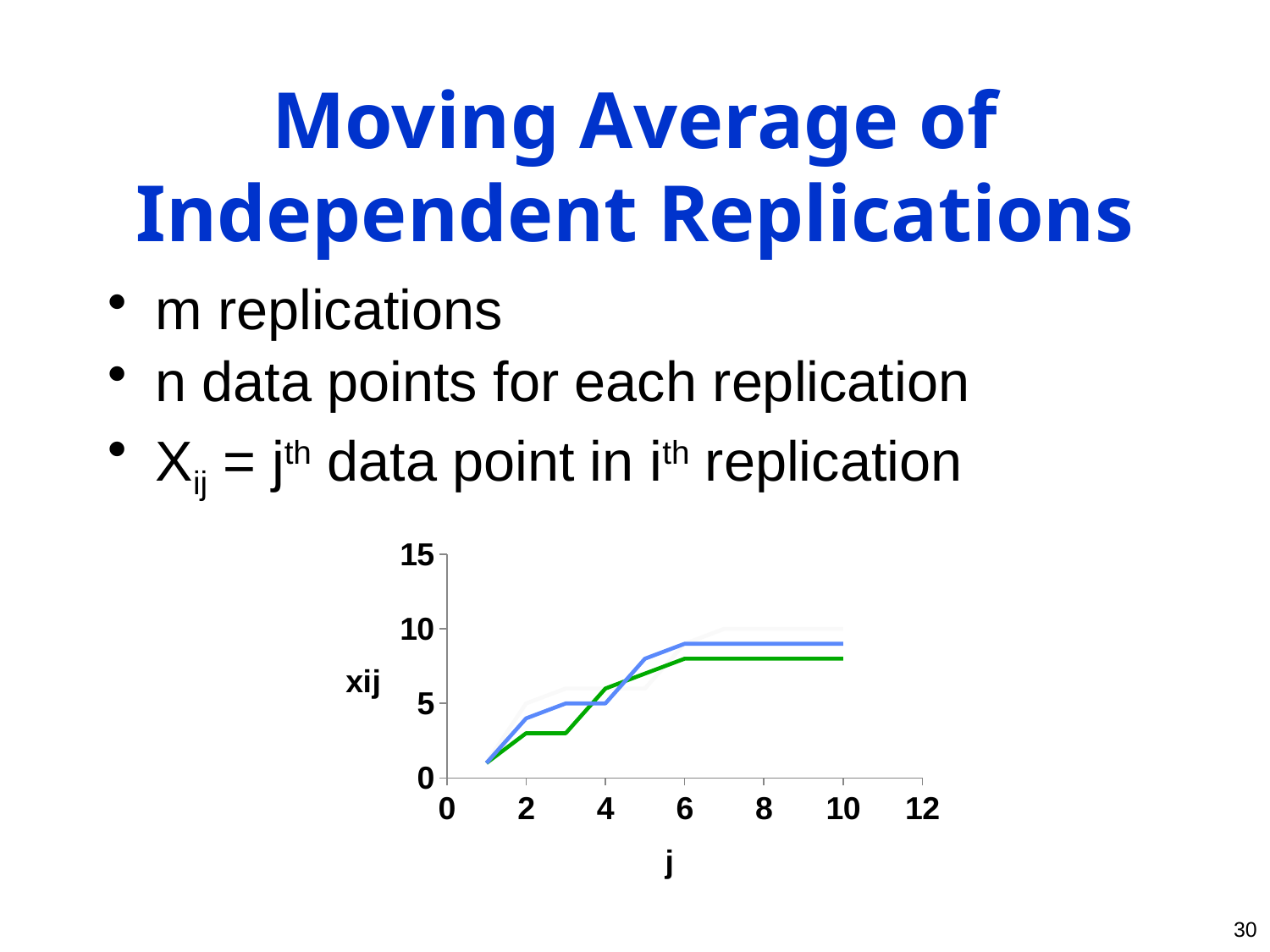
At j = 2, which line has the higher value, the blue line or the green line? blue line At j = 10, which line has the higher value, the blue line or the green line? blue line Is the value of the blue line at j = 10 greater or less than 5? greater What is the label of the y axis of the chart? xij Do the plotted values generally rise or fall as j increases? rise Is the value of the blue line at j = 6 greater or less than 5? greater Is the value of the blue line at j = 1 greater or less than 5? less What is the highest value shown on the y axis of the chart? 15 What kind of chart is shown on the slide? line chart What is the label of the x axis of the chart? j